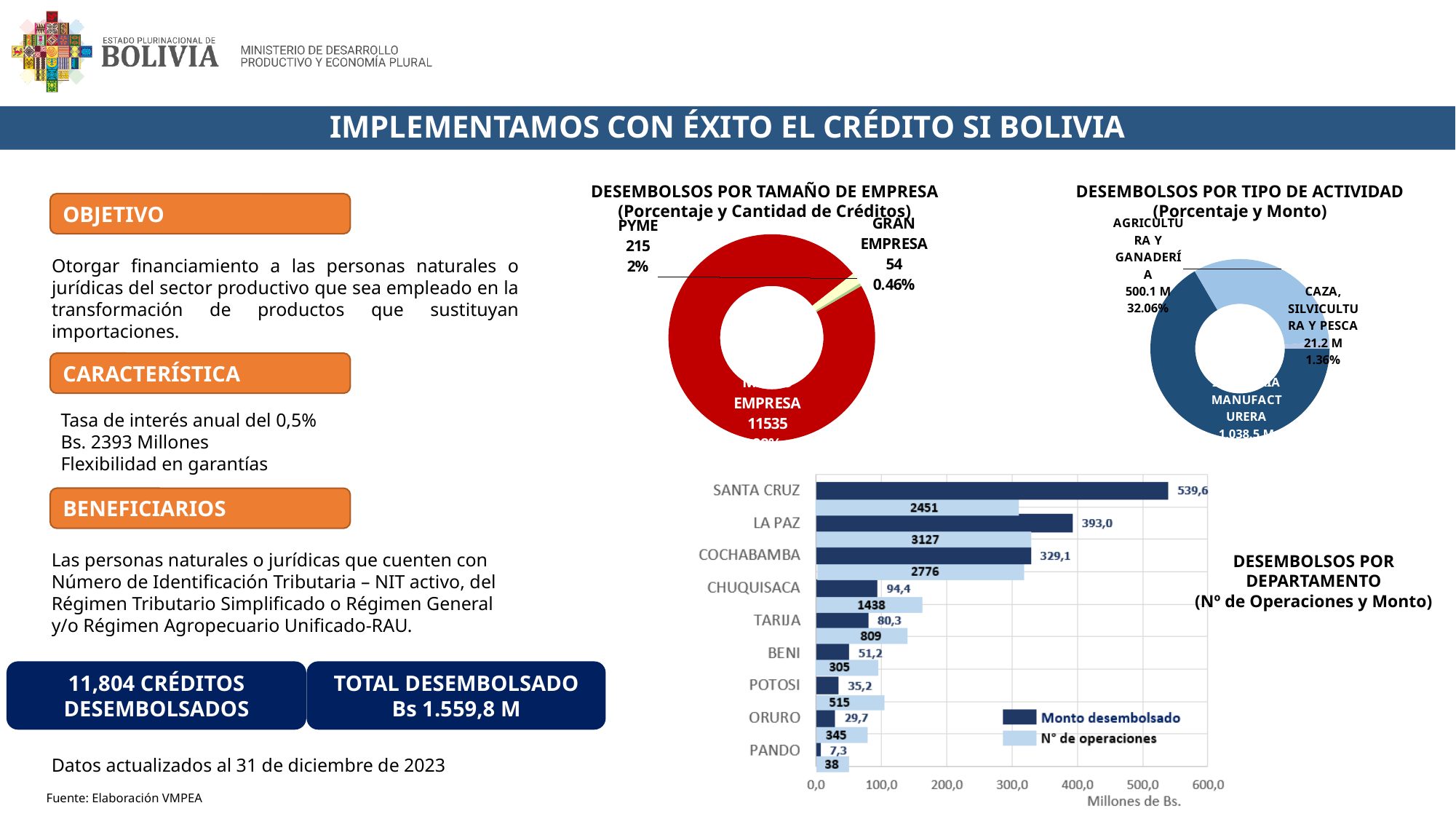
In the DESEMBOLSOS POR TIPO DE ACTIVIDAD chart, what percentage corresponds to AGRICULTURA Y GANADERÍA? 32.06% How many departments are shown in the DESEMBOLSOS POR DEPARTAMENTO chart? 9 In the DESEMBOLSOS POR DEPARTAMENTO chart, what is the N° de operaciones for LA PAZ? 3127 In the DESEMBOLSOS POR TAMAÑO DE EMPRESA chart, how many credits correspond to PYME? 215 In the DESEMBOLSOS POR DEPARTAMENTO chart, which has more N° de operaciones, SANTA CRUZ or LA PAZ? LA PAZ What kind of chart is the DESEMBOLSOS POR DEPARTAMENTO chart? bar chart In the DESEMBOLSOS POR DEPARTAMENTO chart, what is the Monto desembolsado for SANTA CRUZ? 539,6 In the DESEMBOLSOS POR DEPARTAMENTO chart, what is the difference in Monto desembolsado between SANTA CRUZ and LA PAZ? 146,6 In the DESEMBOLSOS POR DEPARTAMENTO chart, which department has the highest Monto desembolsado? SANTA CRUZ In the DESEMBOLSOS POR TAMAÑO DE EMPRESA chart, what percentage corresponds to GRAN EMPRESA? 0.46% How many series does the legend of the DESEMBOLSOS POR DEPARTAMENTO chart list? 2 In the DESEMBOLSOS POR DEPARTAMENTO chart, which department has the lowest N° de operaciones? PANDO